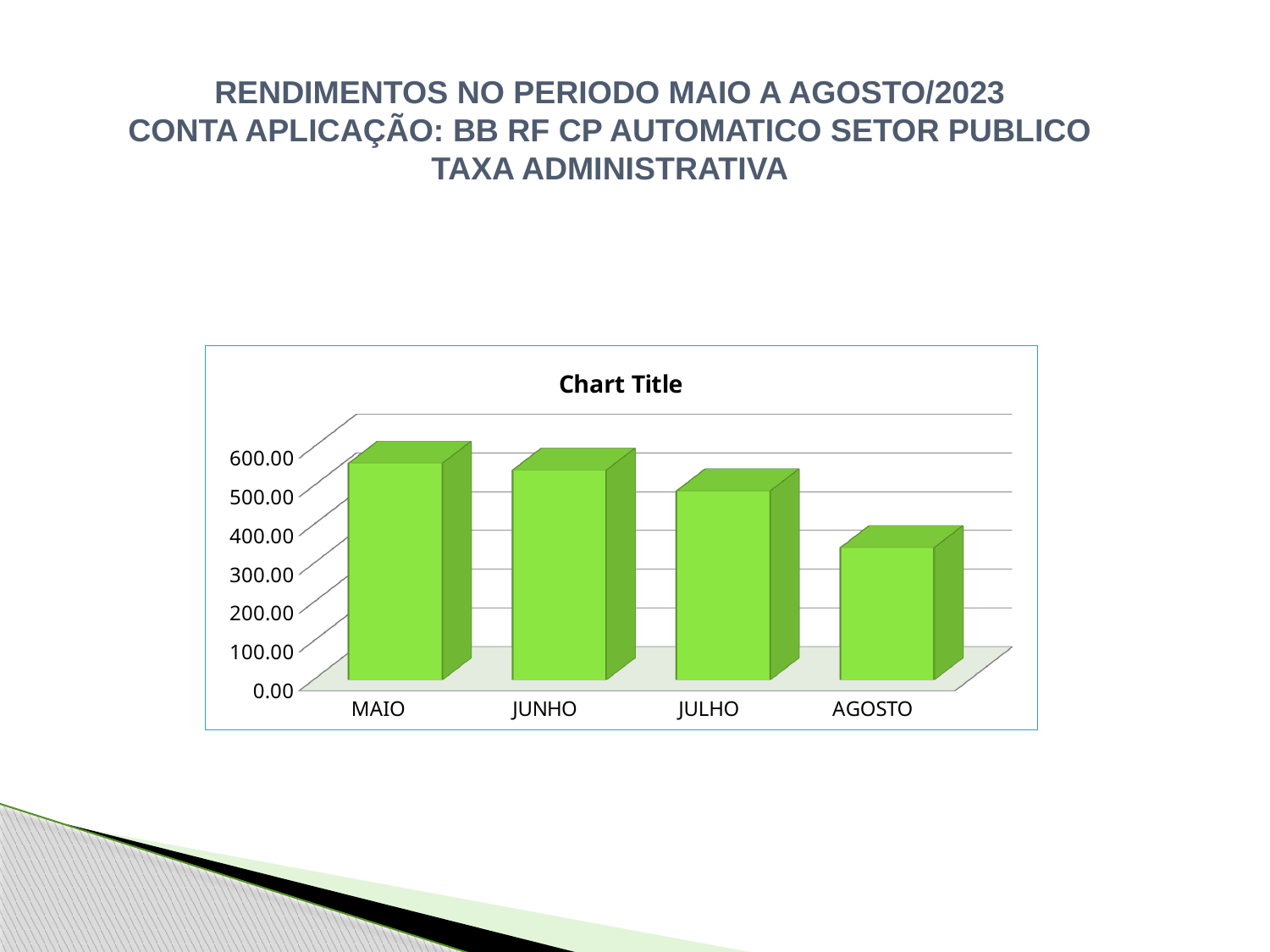
Which month has the lowest value in the chart? AGOSTO Which is larger, the value for MAIO or the value for AGOSTO? MAIO Is the value for AGOSTO greater or less than 500? less Which is larger, the value for JULHO or the value for AGOSTO? JULHO Is the value for JULHO greater or less than 400? greater What kind of chart is shown on the slide? bar chart Is the value for MAIO greater or less than 500? greater What is the title printed inside the chart area? Chart Title Do the values rise or fall from MAIO to AGOSTO along the x axis? fall How many categories are plotted on the x axis of the chart? 4 What colour are the bars in the chart? green